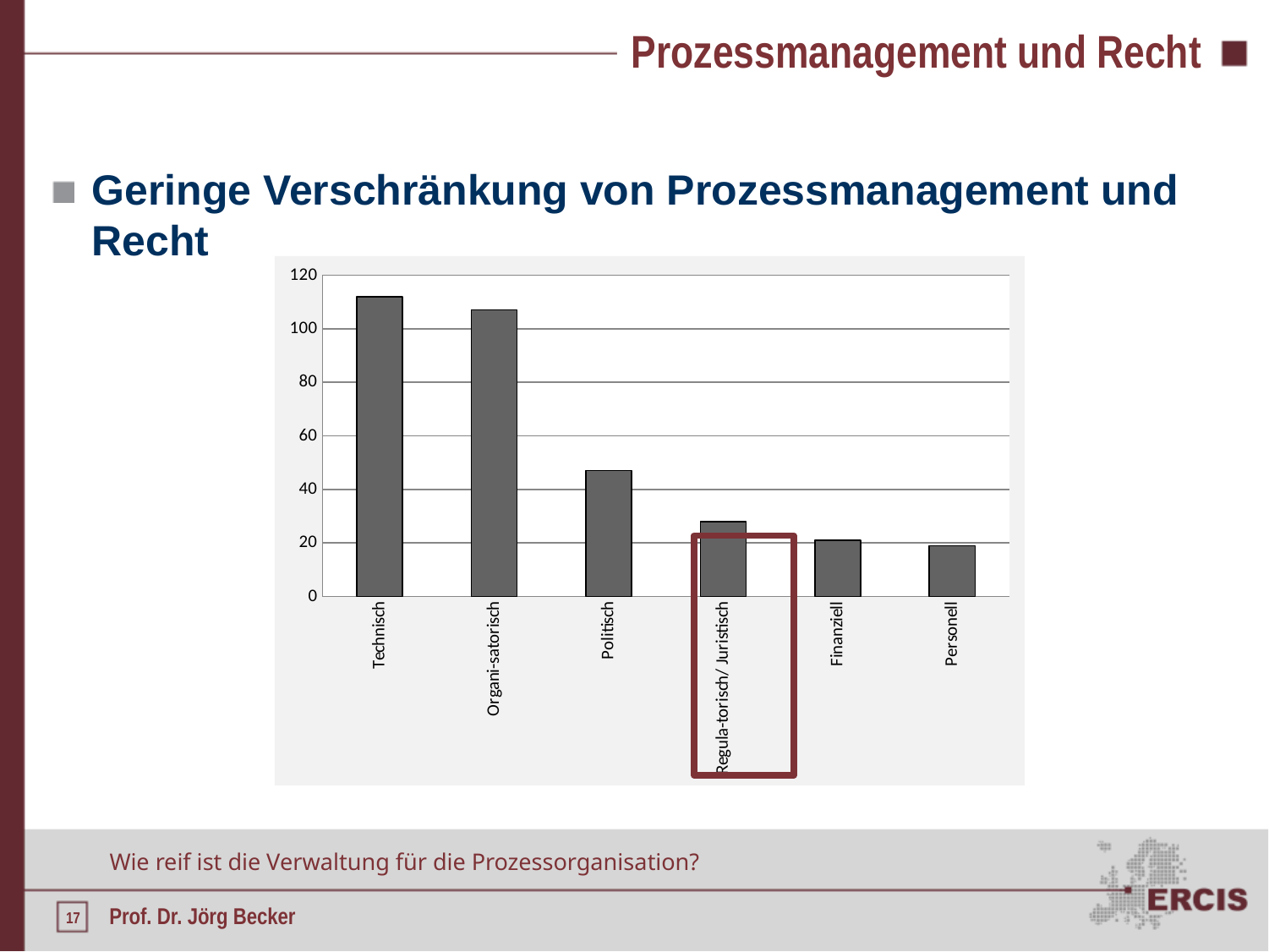
Is the value for Organi-satorisch greater or less than 100? greater Which category has the highest value in the chart? Technisch Do the values rise or fall from left to right along the x axis? fall Which category is highlighted with a red box on the chart? Regula-torisch/ Juristisch Is the value for Technisch greater or less than 100? greater Is the value for Politisch greater or less than 60? less What kind of chart is shown on the slide? bar chart Which is larger, the value for Politisch or the value for Regula-torisch/ Juristisch? Politisch How many categories are shown on the x axis of the chart? 6